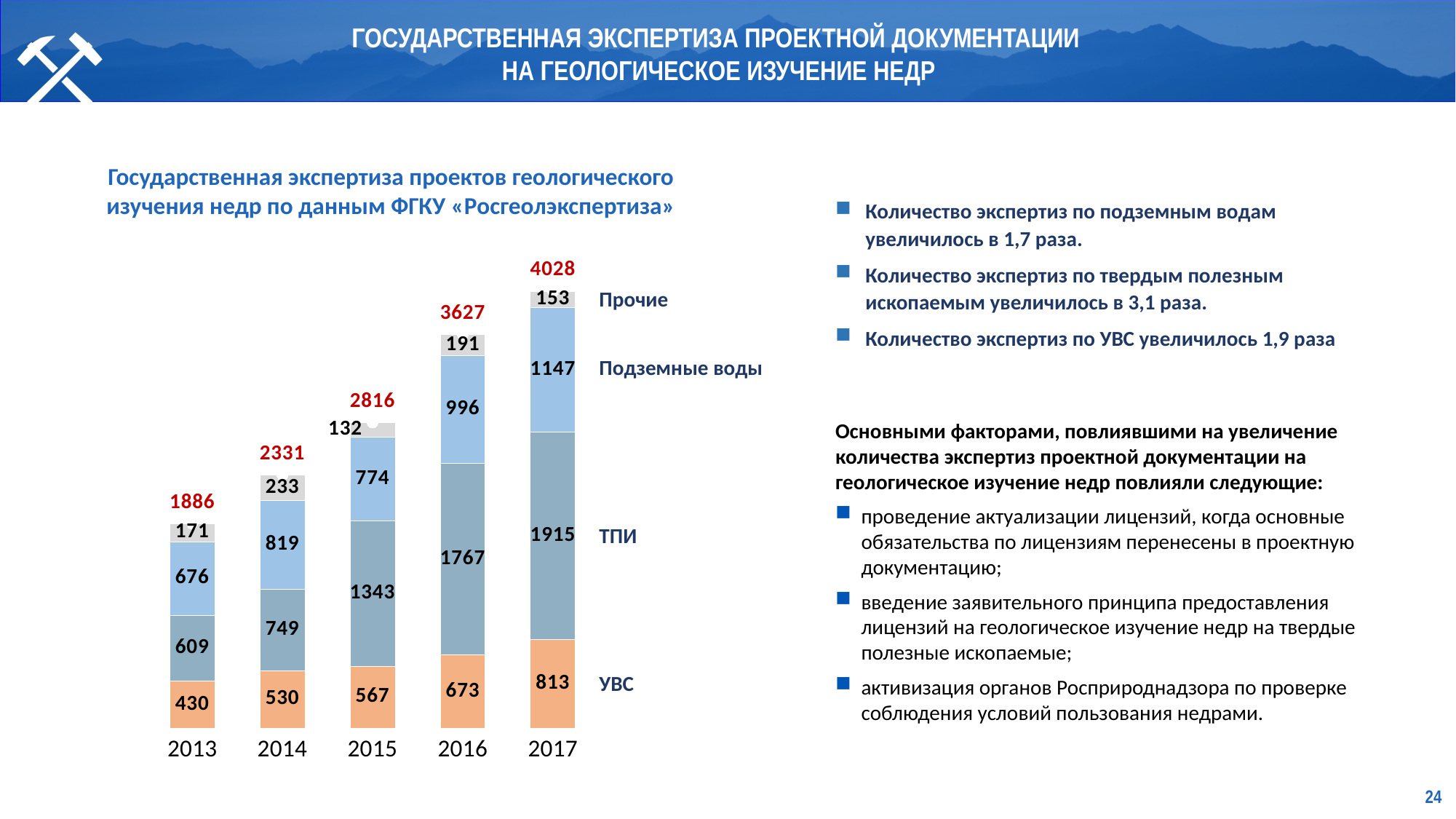
What is the value for УВС in 2017? 813 What is the difference between the ТПИ values for 2017 and 2016? 148 What is the value for ТПИ in 2014? 749 What kind of chart is shown on the slide? Stacked bar chart What is the total of the stacked bar for 2016? 3627 Which is larger: Подземные воды in 2014 or ТПИ in 2014? Подземные воды in 2014 How many series are shown in the stacked bars? 4 What is the value for Подземные воды in 2015? 774 Which year has the lowest value for УВС? 2013 What is the value for Прочие in 2013? 171 Which year has the highest total? 2017 How many years are shown on the x axis? 5